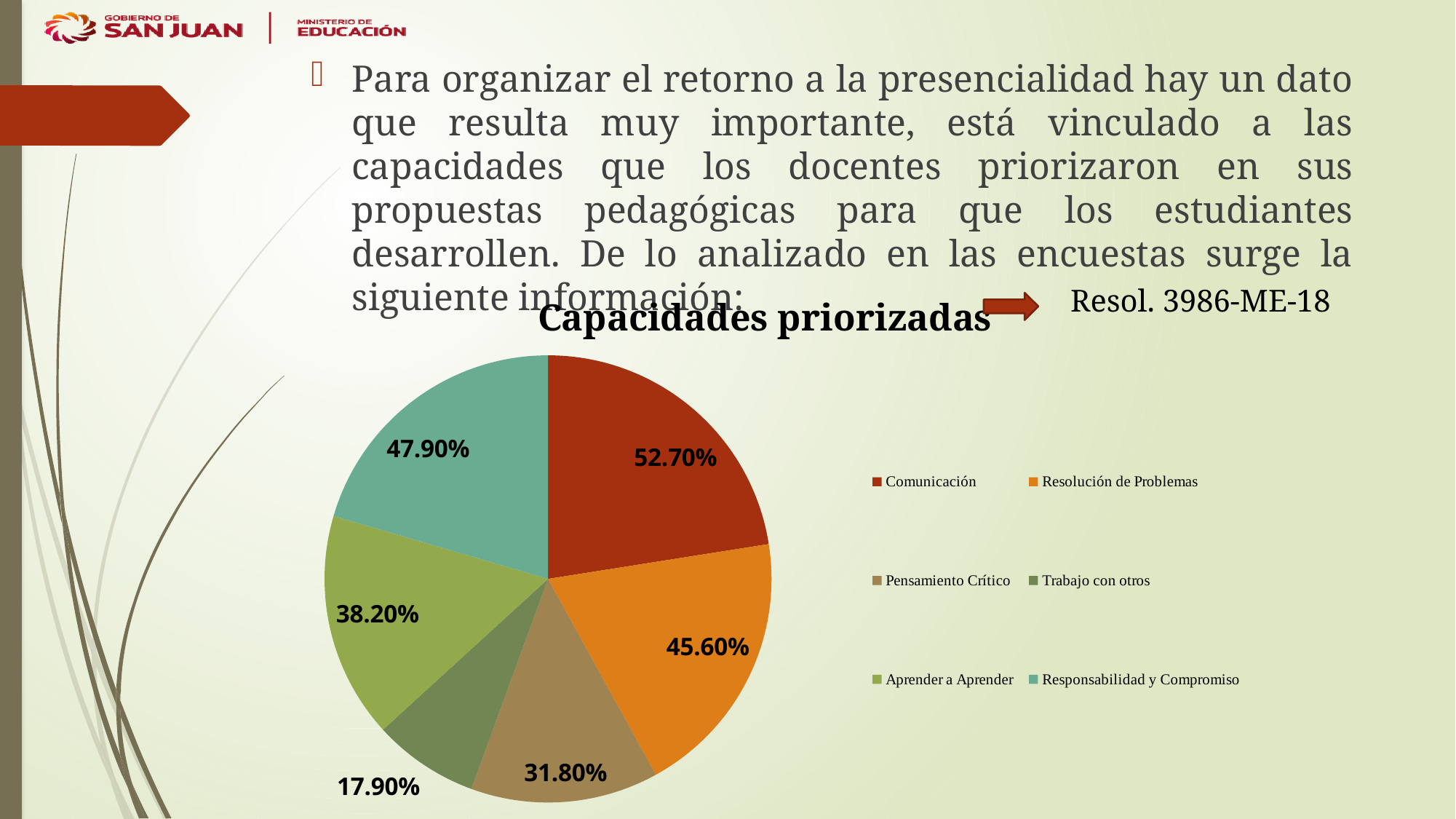
Which category has the lowest value? Trabajo con otros What kind of chart is shown on the slide? pie chart Which category has the highest value? Comunicación What value is shown for Pensamiento Crítico? 31.80% What is the title of the chart? Capacidades priorizadas What value is shown for Aprender a Aprender? 38.20% What value is shown for Trabajo con otros? 17.90% What value is shown for Comunicación? 52.70% How many categories does the pie chart show? 6 What value is shown for Resolución de Problemas? 45.60% What value is shown for Responsabilidad y Compromiso? 47.90% What is the difference between the values for Comunicación and Trabajo con otros? 34.80%